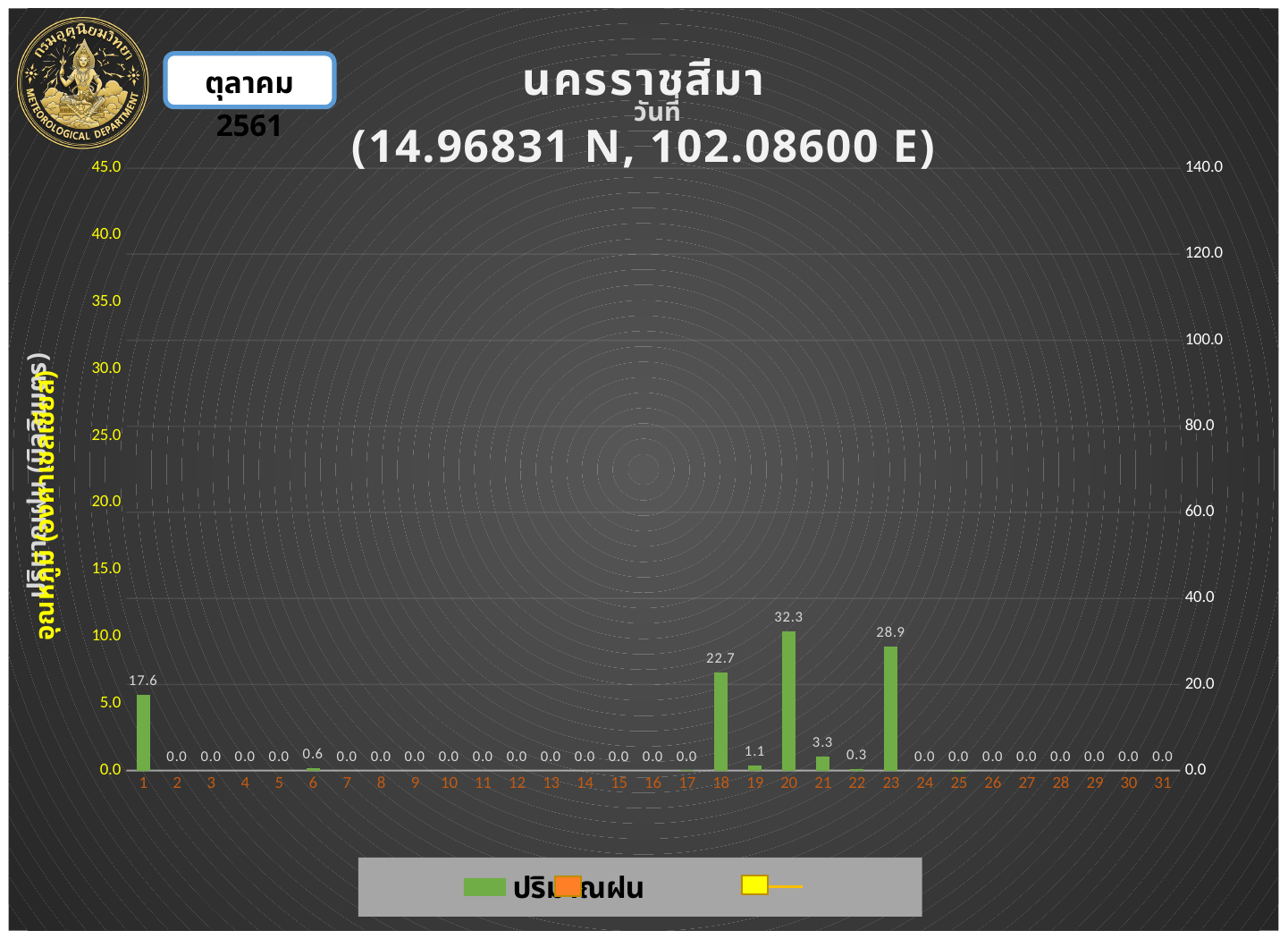
What is the rainfall value shown for day 20? 32.3 Which day has the larger rainfall value, day 18 or day 23? 23 What kind of chart is shown on the slide? bar chart What is the difference between the rainfall values for day 18 and day 1? 5.1 What coordinates are given in the chart title? 14.96831 N, 102.08600 E How many days are shown on the x axis? 31 What is the rainfall value shown for day 1? 17.6 Is the rainfall value for day 20 greater or less than 20.0 on the right-hand axis? greater What is the rainfall value shown for day 19? 1.1 What is the rainfall value shown for day 23? 28.9 Which day has the highest rainfall value? 20 What is the difference between the rainfall values for day 20 and day 23? 3.4